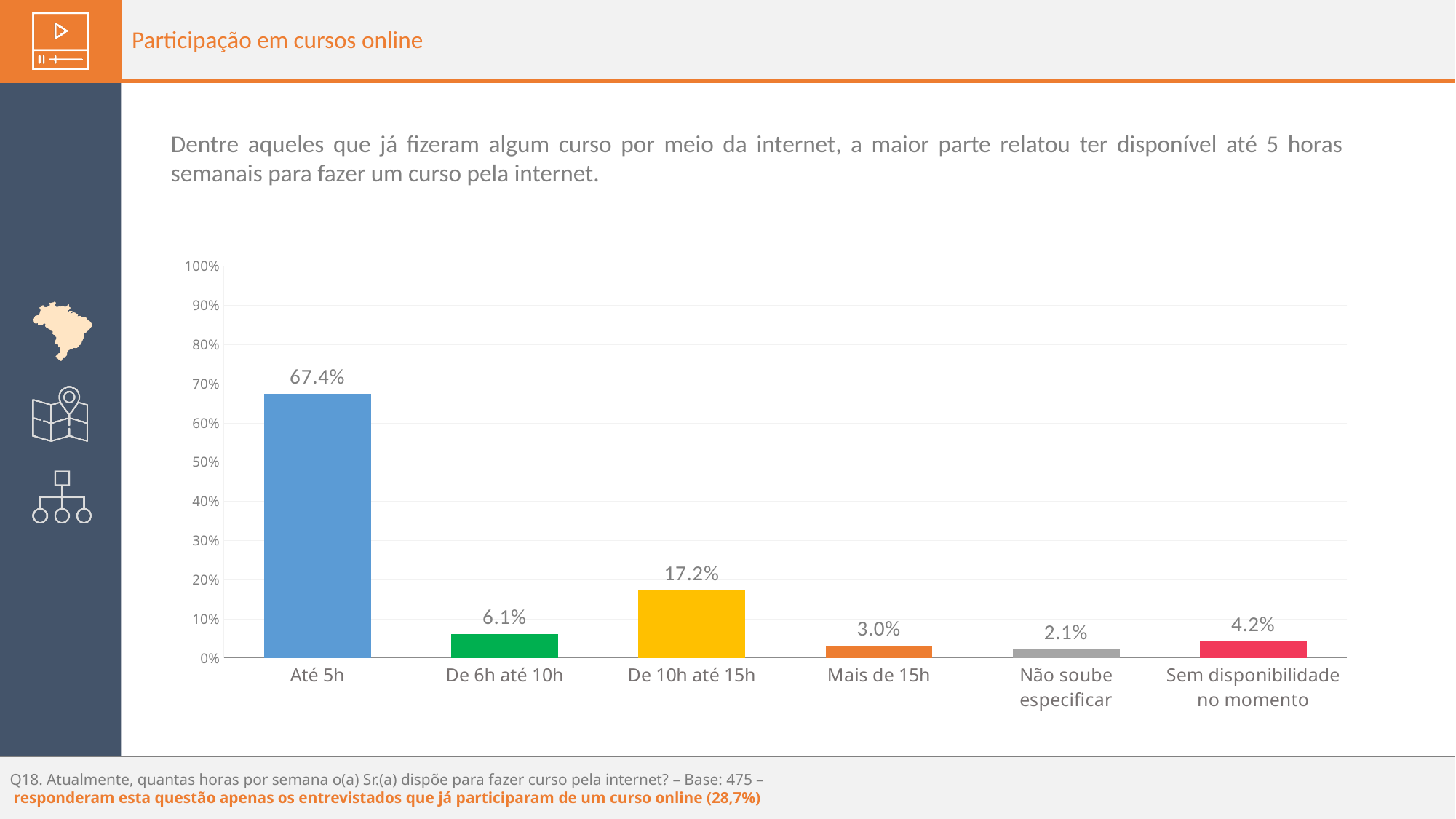
What is the value for "De 10h até 15h"? 17.2% Which category has the highest value? Até 5h Which category has the lowest value? Não soube especificar Is the value for "Até 5h" greater or less than 60%? greater What is the value for "Não soube especificar"? 2.1% What is the value for "Sem disponibilidade no momento"? 4.2% How many categories are shown on the x axis? 6 What kind of chart is shown on the slide? Bar chart What colour is the bar for "De 10h até 15h"? Yellow What is the difference between the values for "Até 5h" and "De 10h até 15h"? 50.2% Which is larger, the value for "De 6h até 10h" or the value for "Sem disponibilidade no momento"? De 6h até 10h What is the value for "Até 5h"? 67.4%